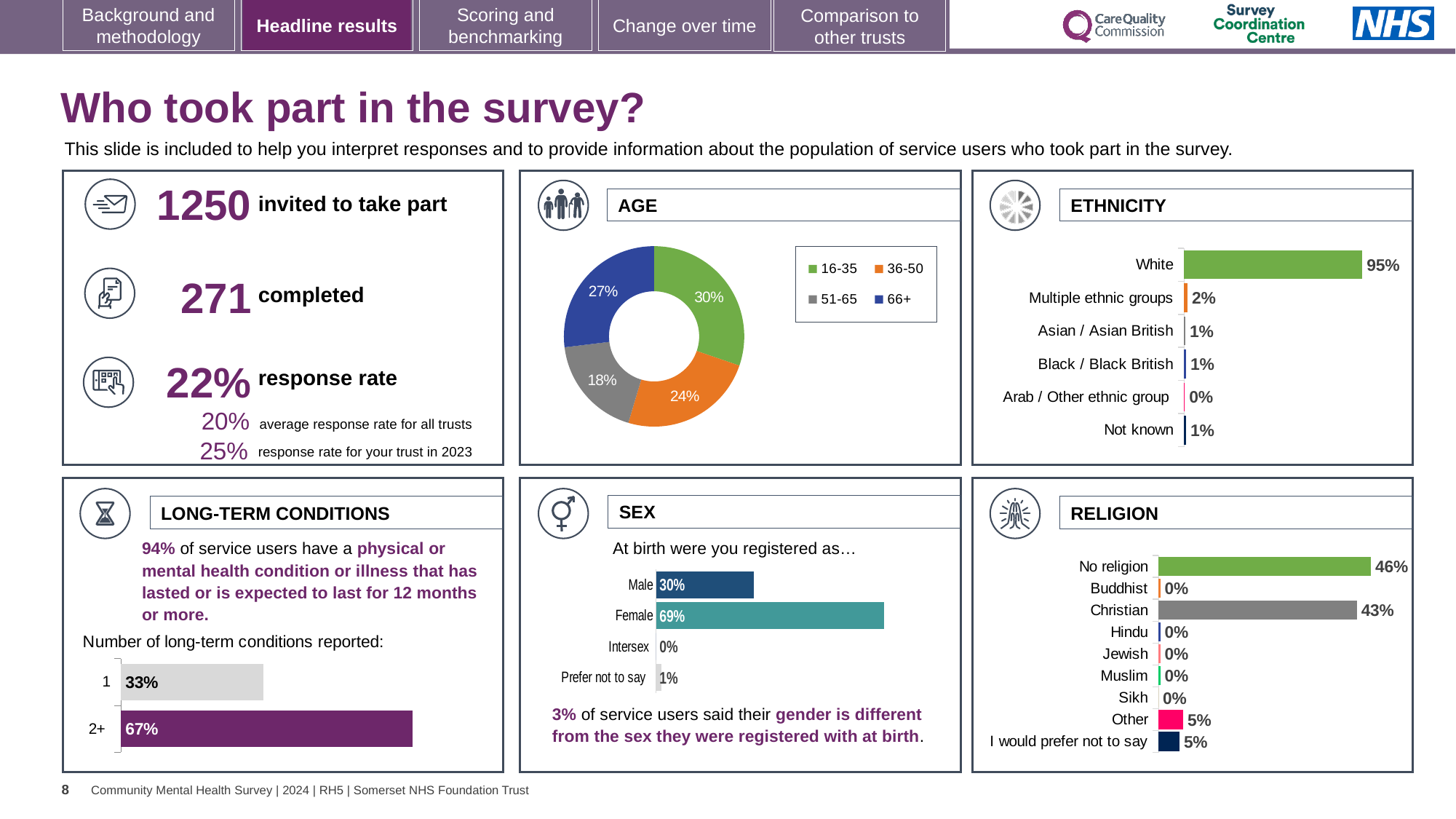
In the AGE chart, what share of respondents are aged 16-35? 30% In the RELIGION chart, which category has the highest value? No religion In the ETHNICITY chart, what is the difference between White and Multiple ethnic groups? 93% In the SEX chart, what is the value for Female? 69% In the RELIGION chart, what is the difference between No religion and Christian? 3% How many age groups does the legend of the AGE chart list? 4 In the AGE chart, which age group has the smallest share? 51-65 What kind of chart is the AGE chart? Doughnut (pie) chart In the LONG-TERM CONDITIONS chart, what share of service users reported 2+ long-term conditions? 67% How many categories are shown in the ETHNICITY chart? 6 In the ETHNICITY chart, what is the value for White? 95% In the SEX chart, which is larger, Male or Female? Female